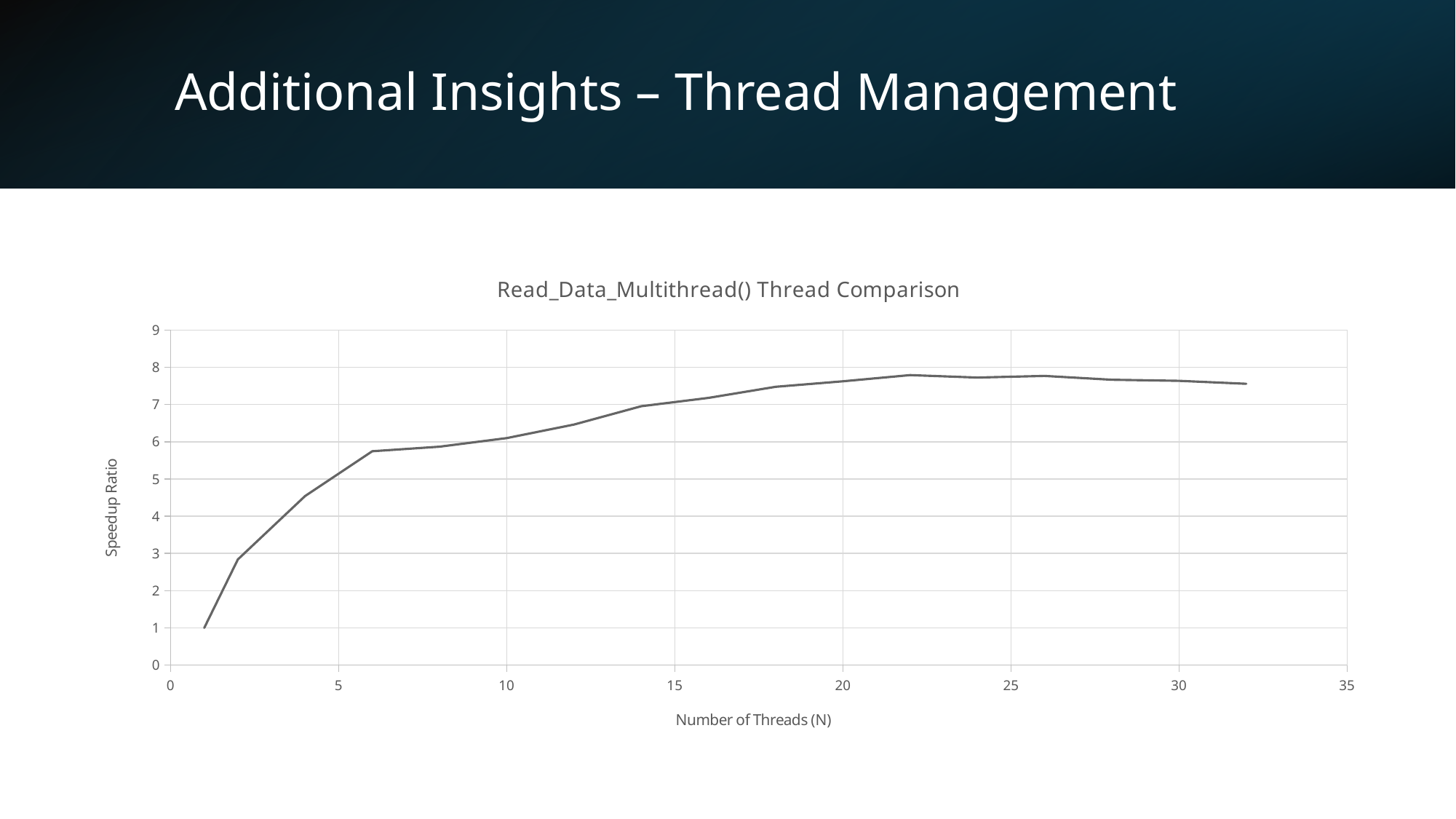
Is the speedup ratio at 10 threads greater or less than 5? greater Is the speedup ratio at 14 threads greater or less than 6? greater Is the speedup ratio at 4 threads greater or less than 4? greater Is the speedup ratio at 20 threads larger or smaller than at 5 threads? larger What is the title of the chart? Read_Data_Multithread() Thread Comparison What kind of chart is shown on the slide? line chart What is the label of the y axis? Speedup Ratio Does the speedup ratio generally rise or fall as the number of threads increases from 1 to 20? rise